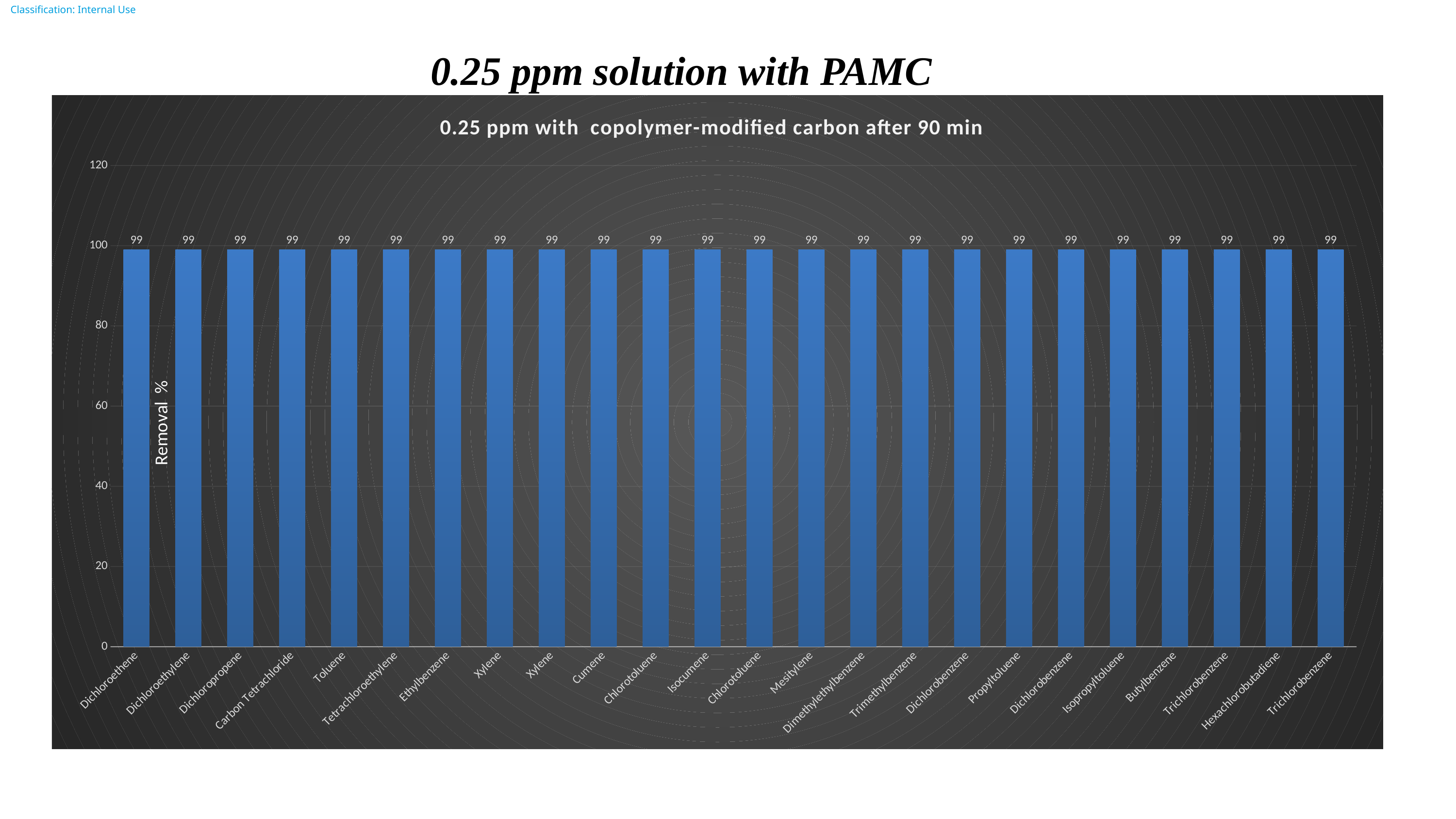
What is the removal % value for Toluene? 99 Do the values rise, fall, or stay flat across the categories along the x axis? stay flat What is the removal % value for Carbon Tetrachloride? 99 How many categories (bars) are plotted in the chart? 24 Is the value for Ethylbenzene greater or less than 80? greater What kind of chart is shown on the slide? bar chart What is the title of the chart? 0.25 ppm with copolymer-modified carbon after 90 min What is the difference between the values for Cumene and Butylbenzene? 0 What is the label on the vertical axis of the chart? Removal % What is the removal % value for Hexachlorobutadiene? 99 Is the value for Isopropyltoluene greater or less than 120? less What is the removal % value for Mesitylene? 99